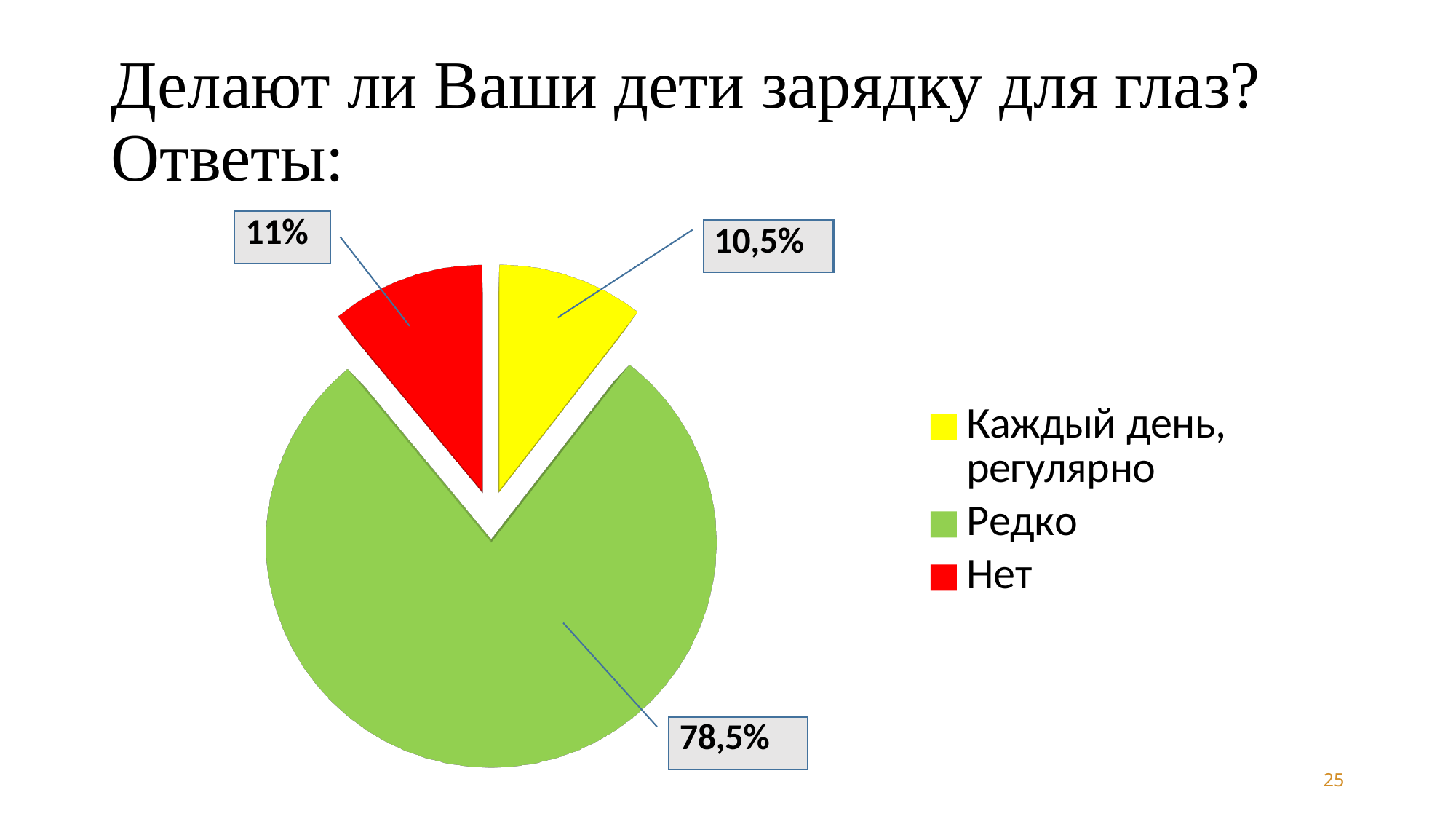
Which category has the largest slice of the pie? Редко How many slices does the pie chart have? 3 How many entries does the legend list? 3 What is the difference between the shares for "Редко" and "Нет"? 67,5% What kind of chart is shown on the slide? pie chart Which is larger, the share for "Нет" or the share for "Каждый день, регулярно"? Нет What share of the pie does "Редко" have? 78,5% Which category has the smallest slice of the pie? Каждый день, регулярно What is the difference between the shares for "Нет" and "Каждый день, регулярно"? 0,5% What share of the pie does "Каждый день, регулярно" have? 10,5% What share of the pie does "Нет" have? 11% What colour is the slice for "Нет"? red